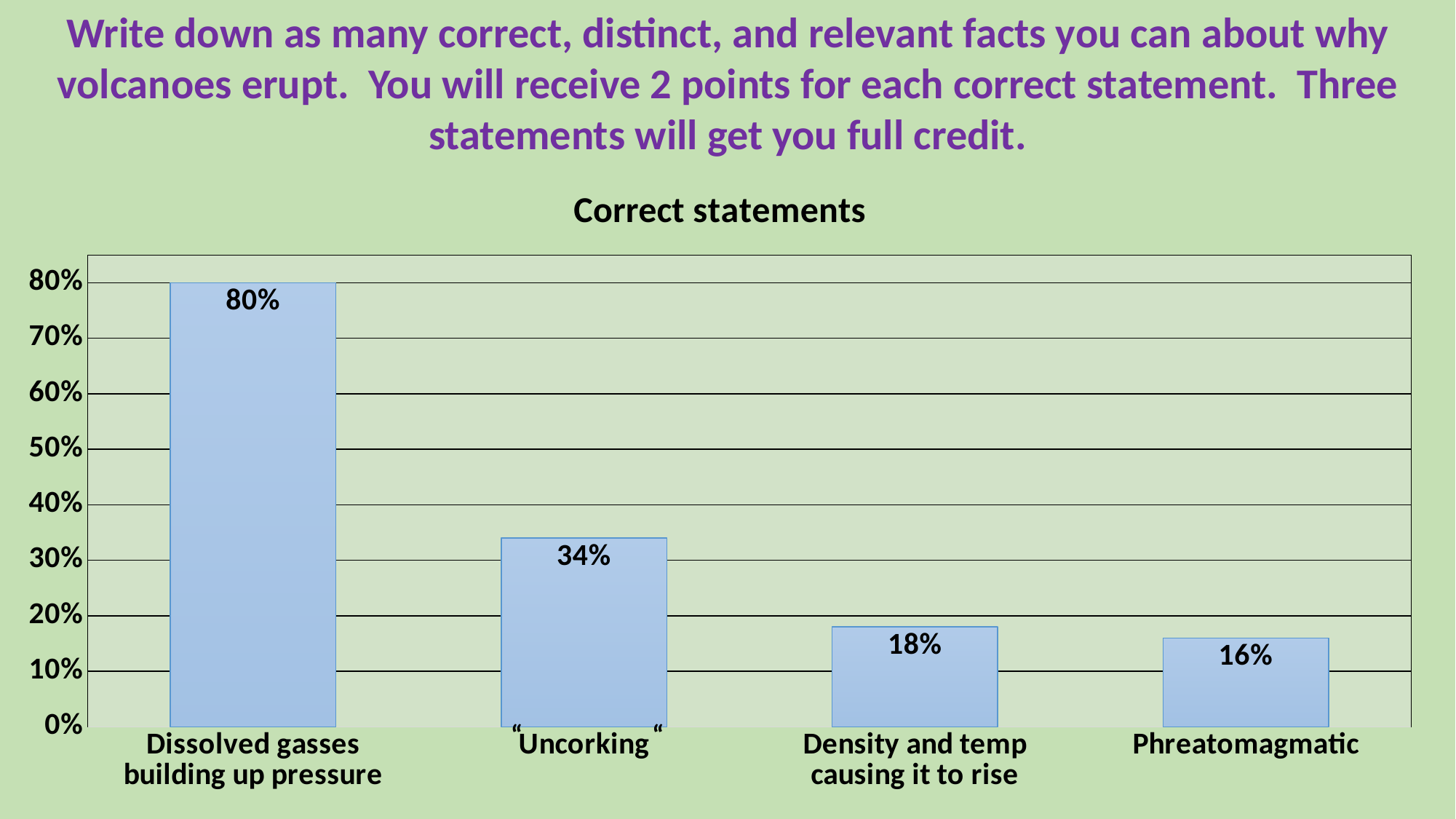
What is the value for "Density and temp causing it to rise"? 18% Which is larger, the value for "Uncorking" or the value for "Density and temp causing it to rise"? Uncorking What is the value for "Phreatomagmatic"? 16% How many categories are shown in the chart? 4 What kind of chart is shown on the slide? Bar chart What is the difference between the values for "Density and temp causing it to rise" and "Phreatomagmatic"? 2% What is the difference between the values for "Dissolved gasses building up pressure" and "Uncorking"? 46% Which category has the highest value? Dissolved gasses building up pressure What is the value for "Uncorking"? 34% What is the value for "Dissolved gasses building up pressure"? 80% What is the title of the chart? Correct statements Which category has the lowest value? Phreatomagmatic